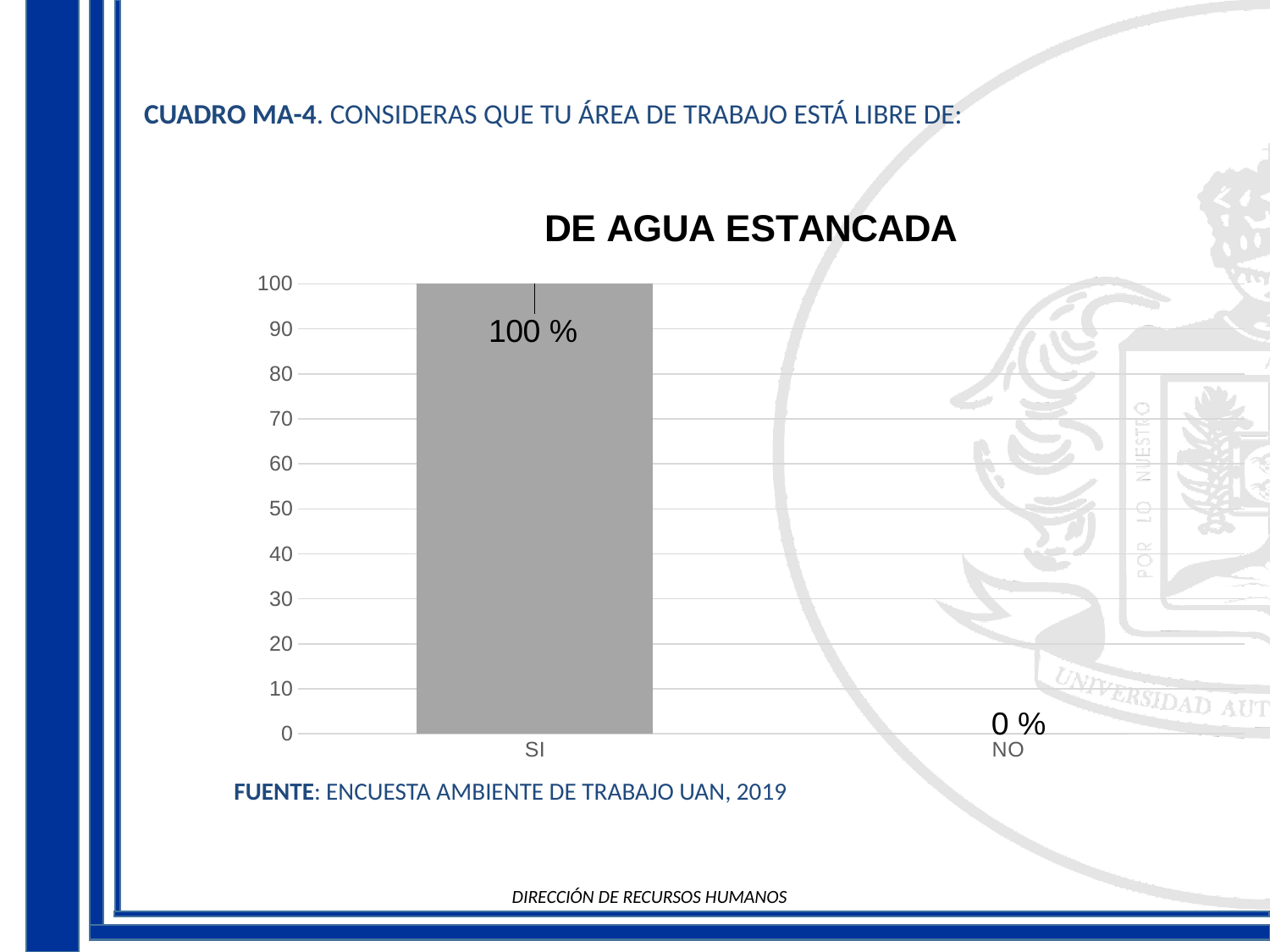
What is the difference between the values for SI and NO? 100 % Is the value for SI greater or less than 50? greater What is the value for SI? 100 % What is the value for NO? 0 % Which category has the highest value? SI What kind of chart is this? bar chart What is the highest value shown on the vertical axis? 100 How many categories are shown on the x axis? 2 What is the title of the chart? DE AGUA ESTANCADA Which is larger, the value for SI or the value for NO? SI Which category has the lowest value? NO Do the values rise or fall from SI to NO? fall